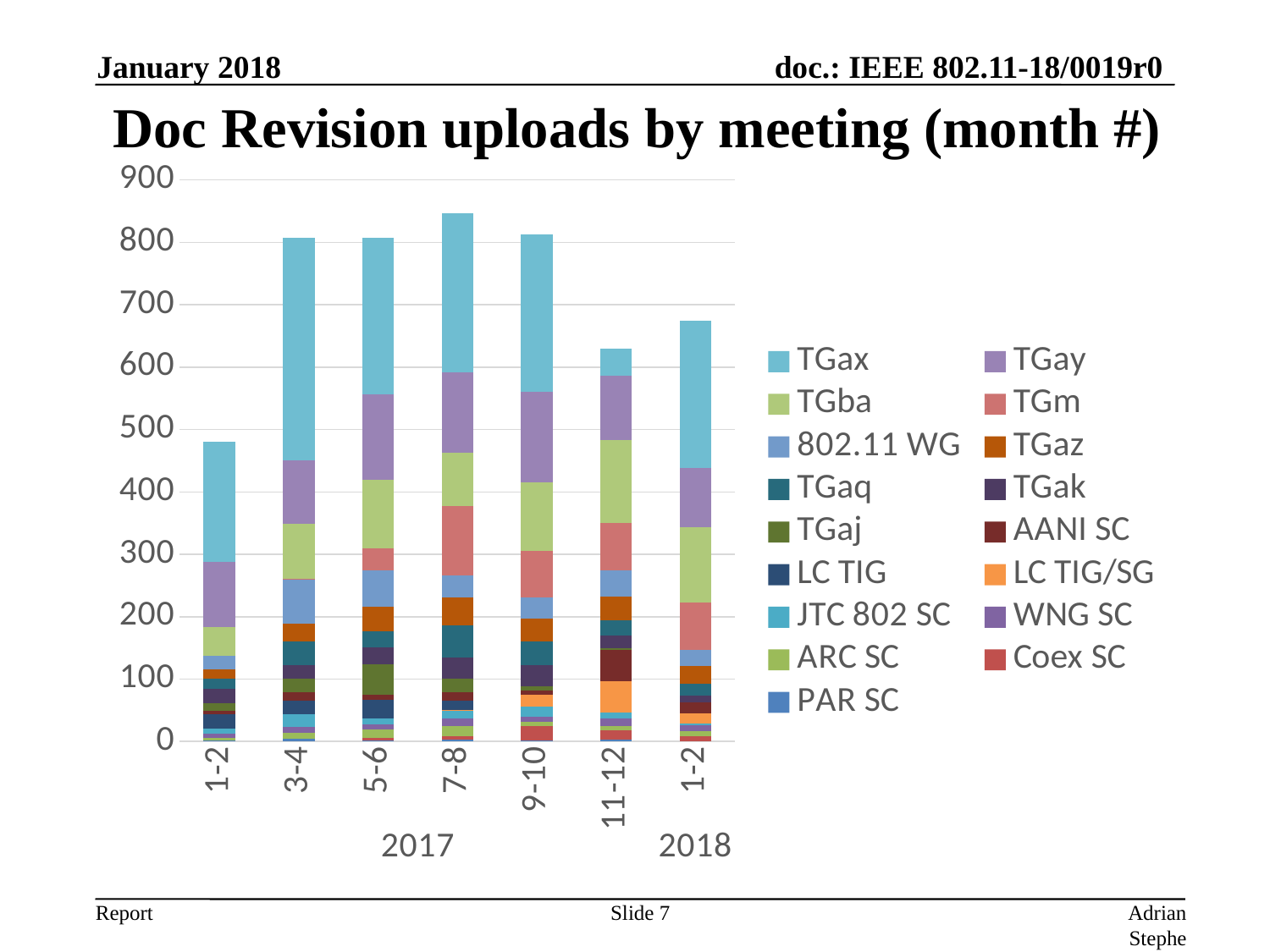
Is the total for the 1-2 2018 meeting greater or less than 700? less What kind of chart is shown on the slide? stacked bar chart Is the total for the 1-2 2017 meeting greater or less than 500? less Which series forms the topmost segment of each stacked bar? TGax Do the total bars rise or fall from the 7-8 2017 meeting to the 11-12 2017 meeting? fall What is the title of the chart? Doc Revision uploads by meeting (month #) Is the total for the 7-8 2017 meeting greater or less than 800? greater Which meeting has the lowest total bar? 1-2 2017 Which has the larger total bar, the 1-2 2017 meeting or the 1-2 2018 meeting? 1-2 2018 How many meeting bars are plotted on the x axis? 7 Which meeting has the highest total bar? 7-8 2017 How many series does the legend list? 17